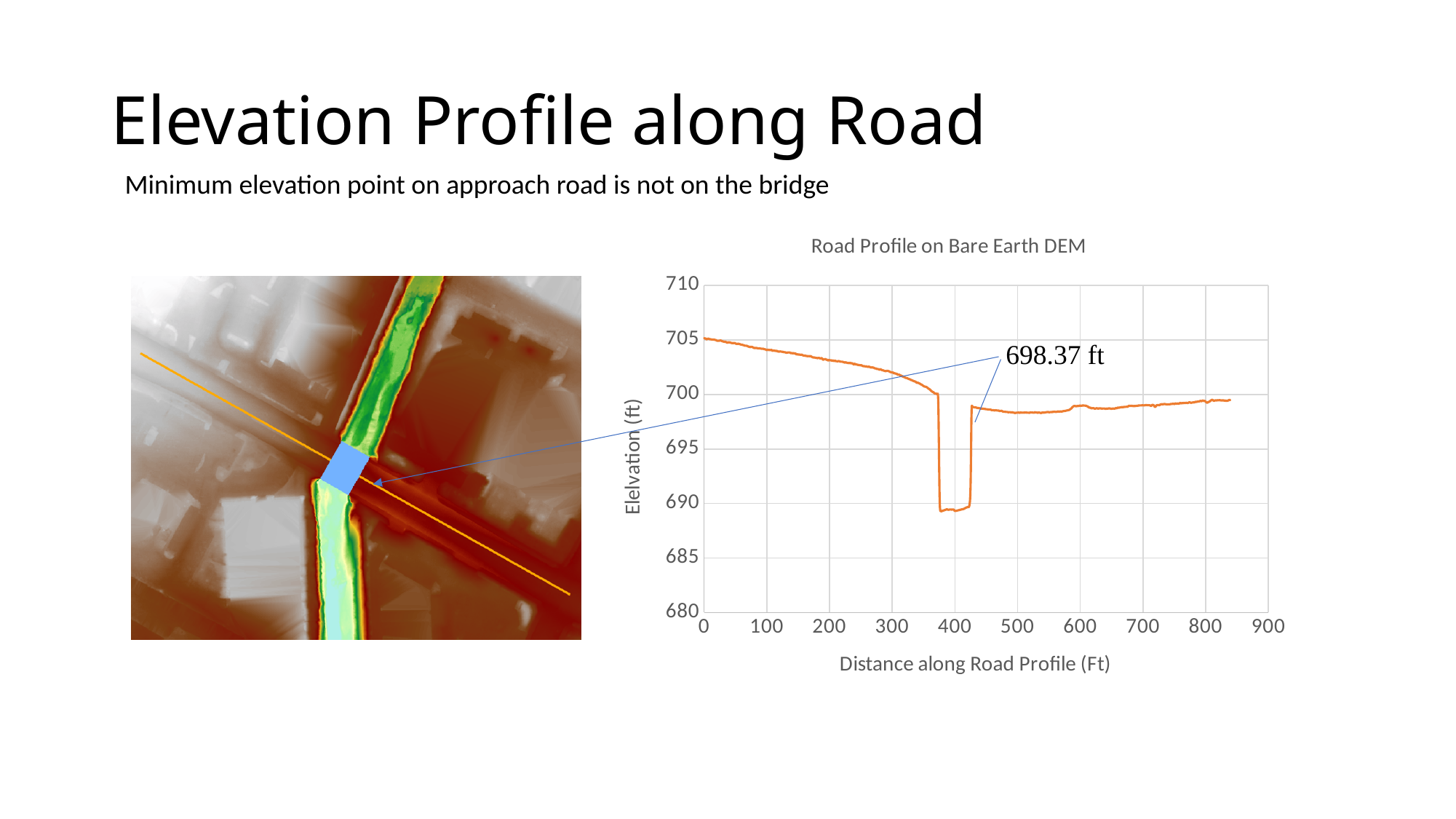
Is the elevation at a distance of 200 ft greater or less than 700? greater Between 0 and 300 ft along the road, does the elevation rise or fall? fall What is the title of the chart? Road Profile on Bare Earth DEM Is the elevation at a distance of 600 ft greater or less than 695? greater Is the elevation at a distance of 0 ft greater or less than 700? greater Around which x-axis tick does the profile reach its lowest elevation? 400 How many lines are plotted on the chart? 1 What is the label of the x axis of the chart? Distance along Road Profile (Ft) What elevation value is annotated on the chart? 698.37 ft What kind of chart is shown on the slide? line chart